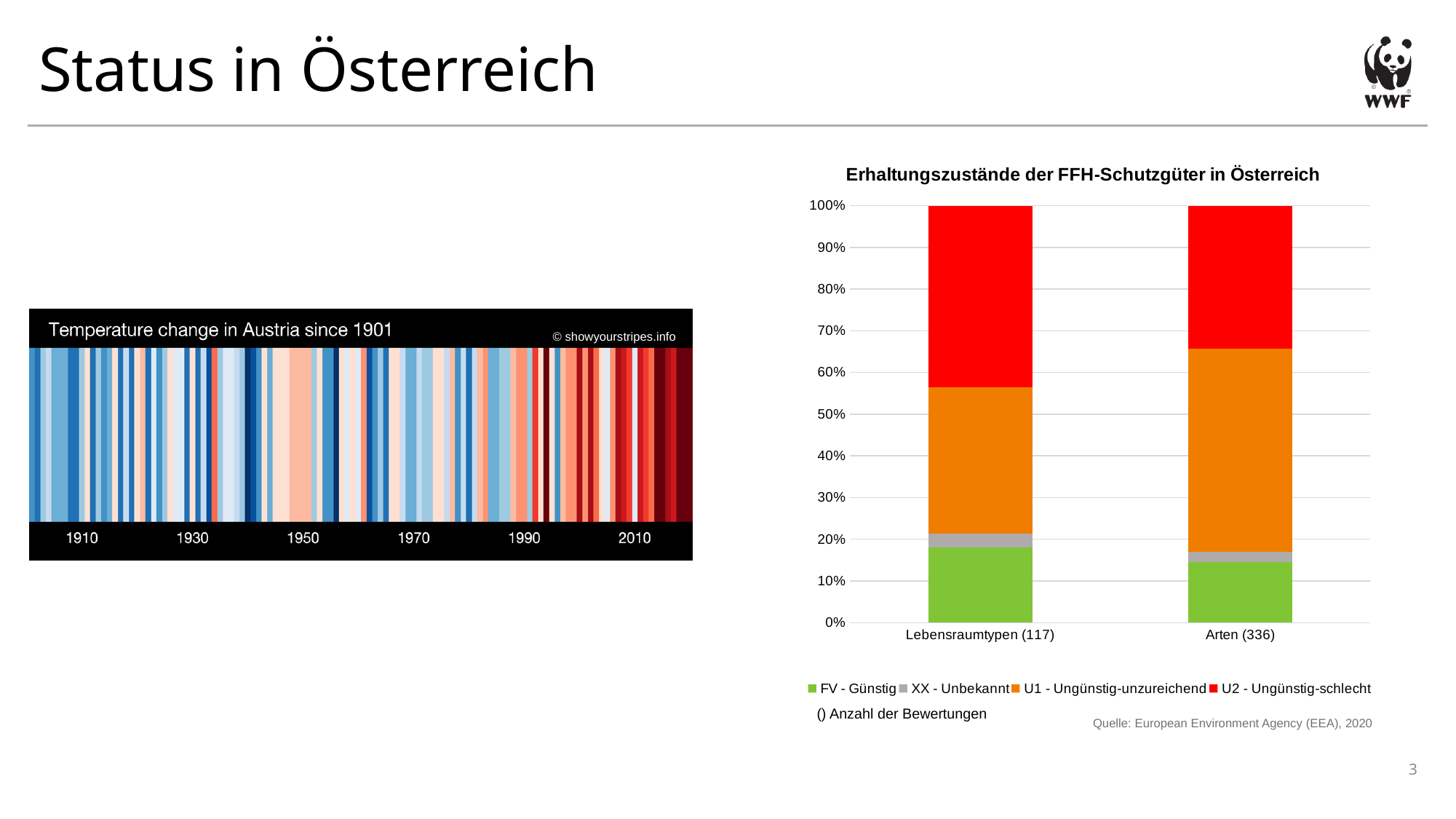
In the chart 'Erhaltungszustände der FFH-Schutzgüter in Österreich', which category has the larger share of 'U2 - Ungünstig-schlecht', Lebensraumtypen (117) or Arten (336)? Lebensraumtypen (117) In the chart 'Erhaltungszustände der FFH-Schutzgüter in Österreich', what is the total height of the stacked bar for Lebensraumtypen (117)? 100% Which colour represents 'FV - Günstig' in the chart 'Erhaltungszustände der FFH-Schutzgüter in Österreich'? green In the chart 'Erhaltungszustände der FFH-Schutzgüter in Österreich', is the share of 'U2 - Ungünstig-schlecht' for Arten (336) greater or less than 30%? greater What kind of chart is 'Erhaltungszustände der FFH-Schutzgüter in Österreich'? stacked bar chart How many series does the legend of the chart 'Erhaltungszustände der FFH-Schutzgüter in Österreich' list? 4 What source is cited below the chart 'Erhaltungszustände der FFH-Schutzgüter in Österreich'? European Environment Agency (EEA), 2020 In the chart 'Erhaltungszustände der FFH-Schutzgüter in Österreich', which category has the larger share of 'U1 - Ungünstig-unzureichend', Lebensraumtypen (117) or Arten (336)? Arten (336) In the chart 'Erhaltungszustände der FFH-Schutzgüter in Österreich', is the share of 'U1 - Ungünstig-unzureichend' for Lebensraumtypen (117) greater or less than 30%? greater In the chart 'Erhaltungszustände der FFH-Schutzgüter in Österreich', is the share of 'FV - Günstig' for Lebensraumtypen (117) greater or less than 10%? greater How many categories are shown on the x axis of the chart 'Erhaltungszustände der FFH-Schutzgüter in Österreich'? 2